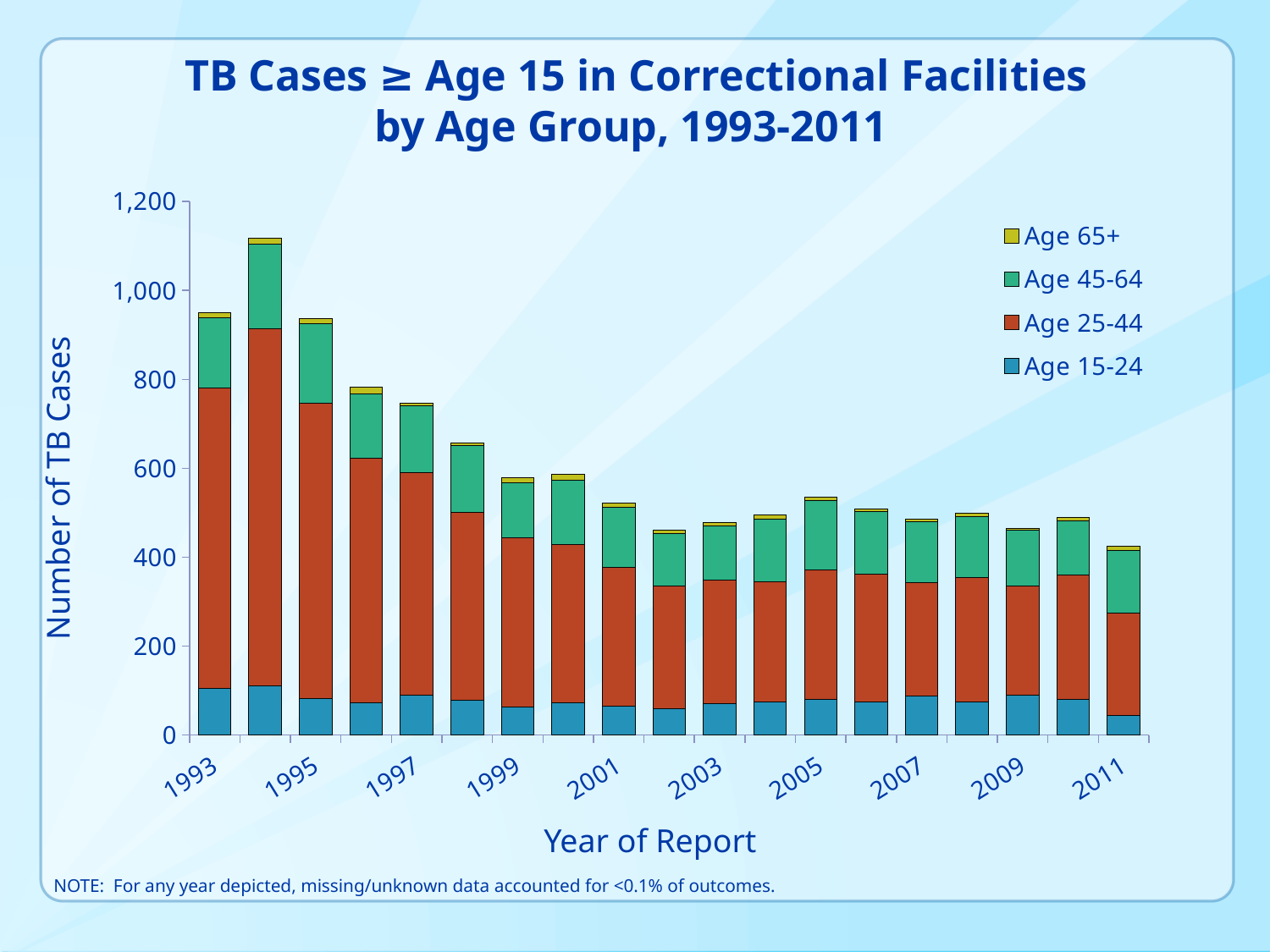
Is the total number of TB cases in 1994 greater or less than 1,000? greater Which year has a higher total number of TB cases, 1994 or 1996? 1994 Which year has the lowest total number of TB cases? 2011 What kind of chart is shown on the slide? Stacked bar chart Which year has the highest total number of TB cases? 1994 How many years (bars) are plotted on the chart? 19 Is the total number of TB cases in 2001 greater or less than 600? less Is the total number of TB cases in 2011 greater or less than 600? less What is the label of the x axis? Year of Report Overall, do total TB cases rise or fall from 1993 to 2011? fall How many series does the legend list? 4